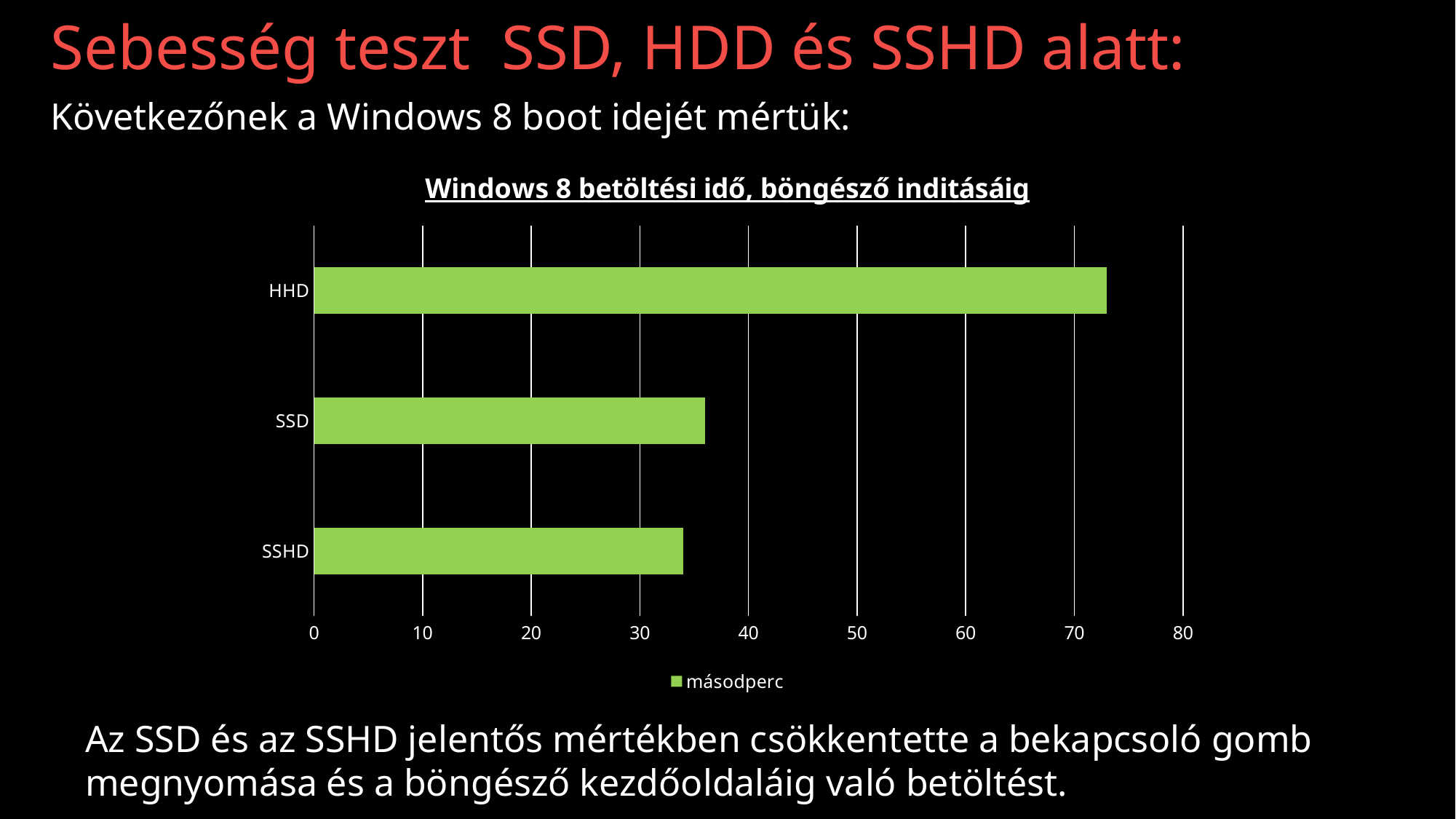
Which is larger, the value for HHD or the value for SSD? HHD What is the title of the chart? Windows 8 betöltési idő, böngésző inditásáig Is the value for SSD greater or less than 30? greater How many series does the chart legend list? 1 Is the value for SSHD greater or less than 40? less Is the value for HHD greater or less than 70? greater Which category has the highest value in the chart? HHD What series name is shown in the chart legend? másodperc How many categories are plotted in the chart? 3 What kind of chart is shown on the slide? bar chart